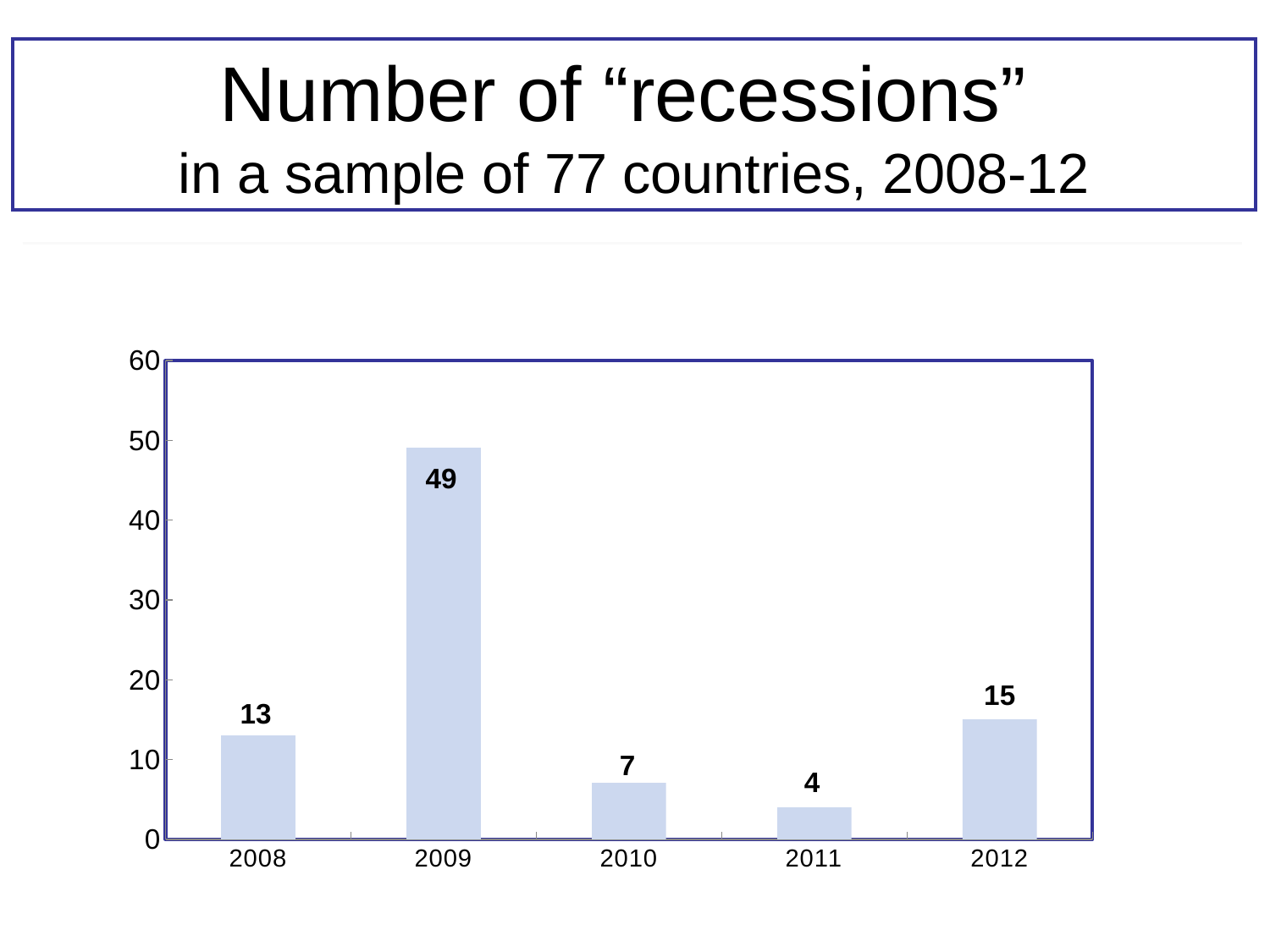
What is the value shown for 2012? 15 Which year has a larger value, 2008 or 2012? 2012 What is the difference between the values for 2009 and 2008? 36 Which year has the highest number of recessions? 2009 What is the title of the chart? Number of "recessions" in a sample of 77 countries, 2008-12 What is the difference between the values for 2012 and 2010? 8 Is the value for 2009 greater or less than 40? greater Which year has the lowest number of recessions? 2011 How many years are shown on the x axis? 5 What is the value shown for 2011? 4 What kind of chart is shown on the slide? bar chart How many recessions were recorded in 2009? 49